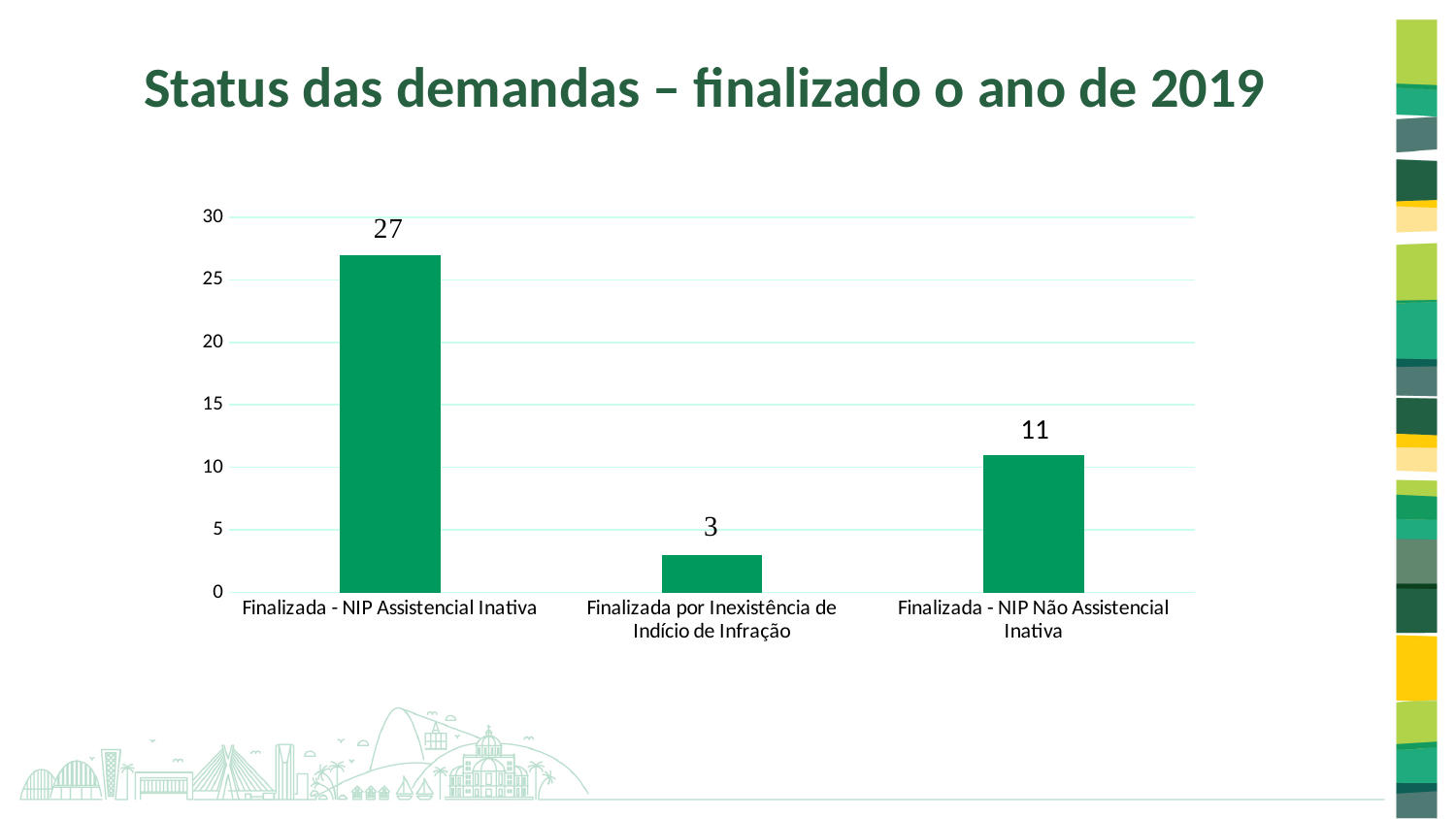
What kind of chart is shown on the slide? Bar chart Which is larger: the value for "Finalizada - NIP Não Assistencial Inativa" or for "Finalizada por Inexistência de Indício de Infração"? Finalizada - NIP Não Assistencial Inativa Which category has the lowest value? Finalizada por Inexistência de Indício de Infração What is the title of the slide? Status das demandas – finalizado o ano de 2019 Which category has the highest value? Finalizada - NIP Assistencial Inativa How many categories are shown in the chart? 3 What is the difference between the values for "Finalizada - NIP Não Assistencial Inativa" and "Finalizada por Inexistência de Indício de Infração"? 8 What is the value for "Finalizada - NIP Não Assistencial Inativa"? 11 What is the value for "Finalizada - NIP Assistencial Inativa"? 27 What is the difference between the values for "Finalizada - NIP Assistencial Inativa" and "Finalizada - NIP Não Assistencial Inativa"? 16 Is the value for "Finalizada - NIP Assistencial Inativa" greater or less than 25? greater What is the value for "Finalizada por Inexistência de Indício de Infração"? 3